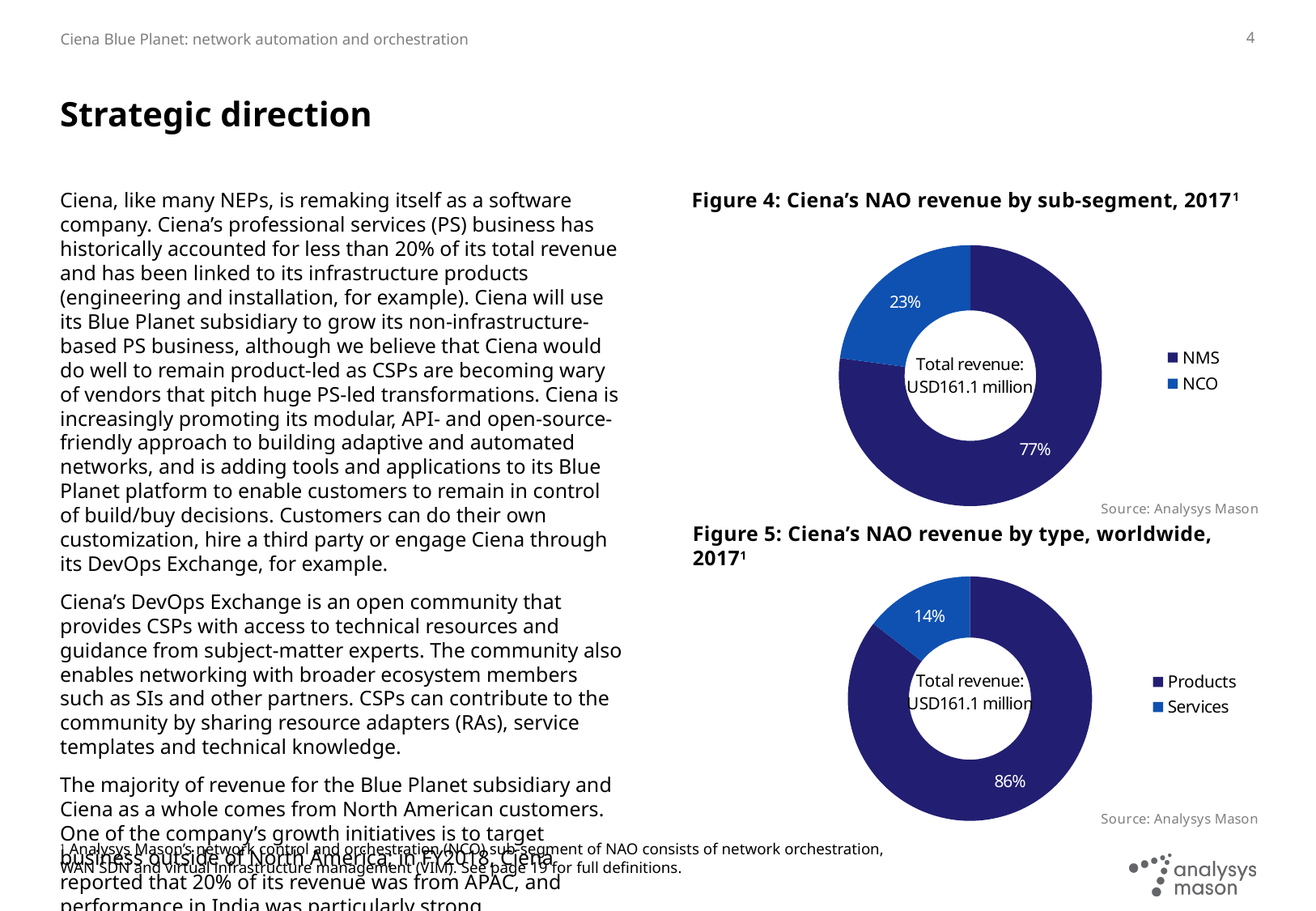
Which is larger: the NCO share in Figure 4 or the Services share in Figure 5? NCO share in Figure 4 In Figure 4 (Ciena's NAO revenue by sub-segment, 2017), what share of revenue does NMS account for? 77% In Figure 5 (Ciena's NAO revenue by type, worldwide, 2017), what share of revenue comes from Products? 86% In Figure 4 (Ciena's NAO revenue by sub-segment, 2017), which sub-segment has the largest share? NMS In Figure 5 (Ciena's NAO revenue by type, worldwide, 2017), which type has the smallest share? Services What kind of chart is Figure 5 (Ciena's NAO revenue by type, worldwide, 2017)? Doughnut (pie) chart How many categories does the legend of Figure 4 (Ciena's NAO revenue by sub-segment, 2017) list? 2 In Figure 4 (Ciena's NAO revenue by sub-segment, 2017), what total revenue is shown in the centre of the chart? USD161.1 million In Figure 5 (Ciena's NAO revenue by type, worldwide, 2017), what is the difference in percentage points between the Products and Services shares? 72 percentage points In Figure 4 (Ciena's NAO revenue by sub-segment, 2017), what is the difference in percentage points between the NMS and NCO shares? 54 percentage points In Figure 5 (Ciena's NAO revenue by type, worldwide, 2017), what share of revenue comes from Services? 14% In Figure 4 (Ciena's NAO revenue by sub-segment, 2017), what share of revenue does NCO account for? 23%